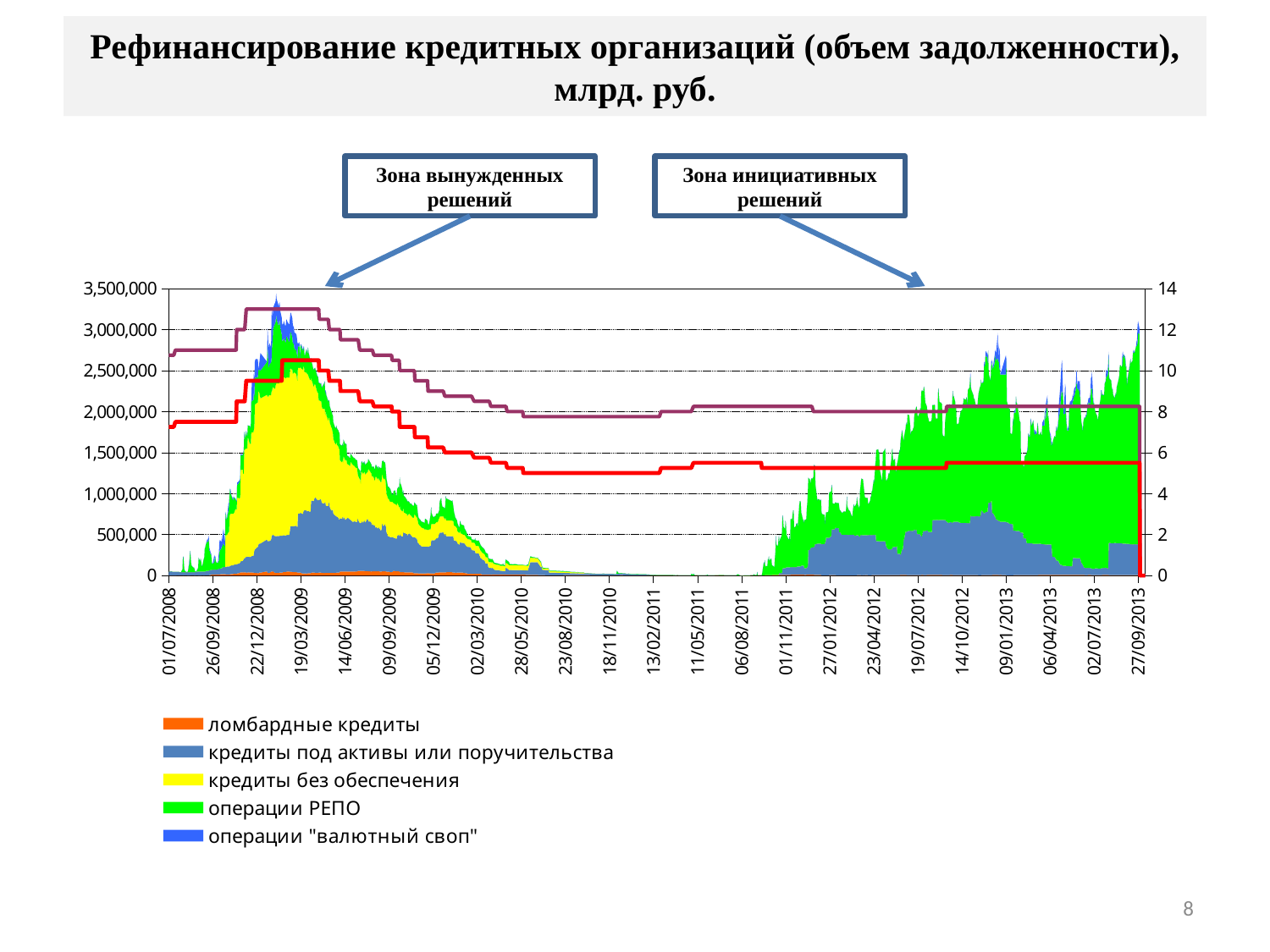
Which colour represents the series "операции РЕПО" in the legend? green What kind of chart is shown on the slide? area chart Which series makes up the largest part of the stacked area at its peak in early 2009: "кредиты без обеспечения" or "ломбардные кредиты"? кредиты без обеспечения Is the total stacked value around 13/02/2011 greater or less than 500,000 on the left axis? less Is the peak of the stacked area in early 2009 greater or less than 3,000,000 on the left axis? greater Is the highest point of the purple line greater or less than 12 on the right axis? greater Does the red line rise or fall between 19/03/2009 and 28/05/2010? fall What is the title of the chart? Рефинансирование кредитных организаций (объем задолженности), млрд. руб. How many series does the legend list? 5